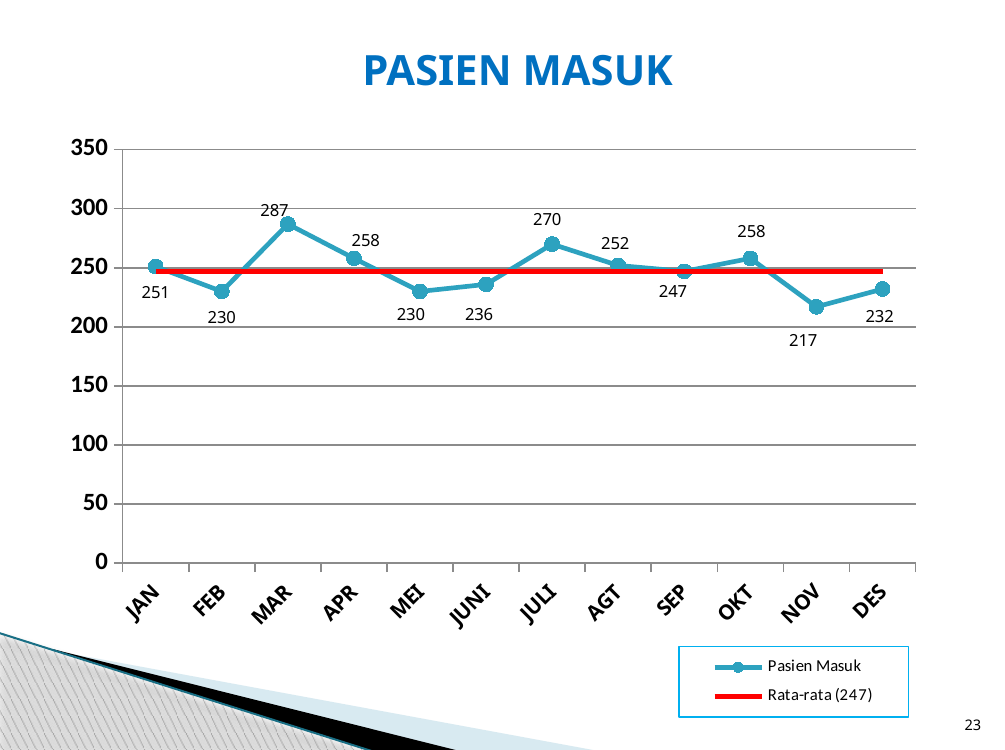
Which month has the highest Pasien Masuk value? MAR What is the value for NOV in the Pasien Masuk chart? 217 How many months are plotted on the x axis of the chart? 12 Which month has the lowest Pasien Masuk value? NOV How many series does the legend list? 2 What is the difference between the Pasien Masuk values for MAR and NOV? 70 What is the value for MAR in the Pasien Masuk chart? 287 Is the Pasien Masuk value for DES greater or less than 250? less What is the title of the chart? PASIEN MASUK What kind of chart is shown on the slide? line chart Which is larger, the Pasien Masuk value for JULI or for AGT? JULI What value does the Rata-rata line represent according to the legend? 247